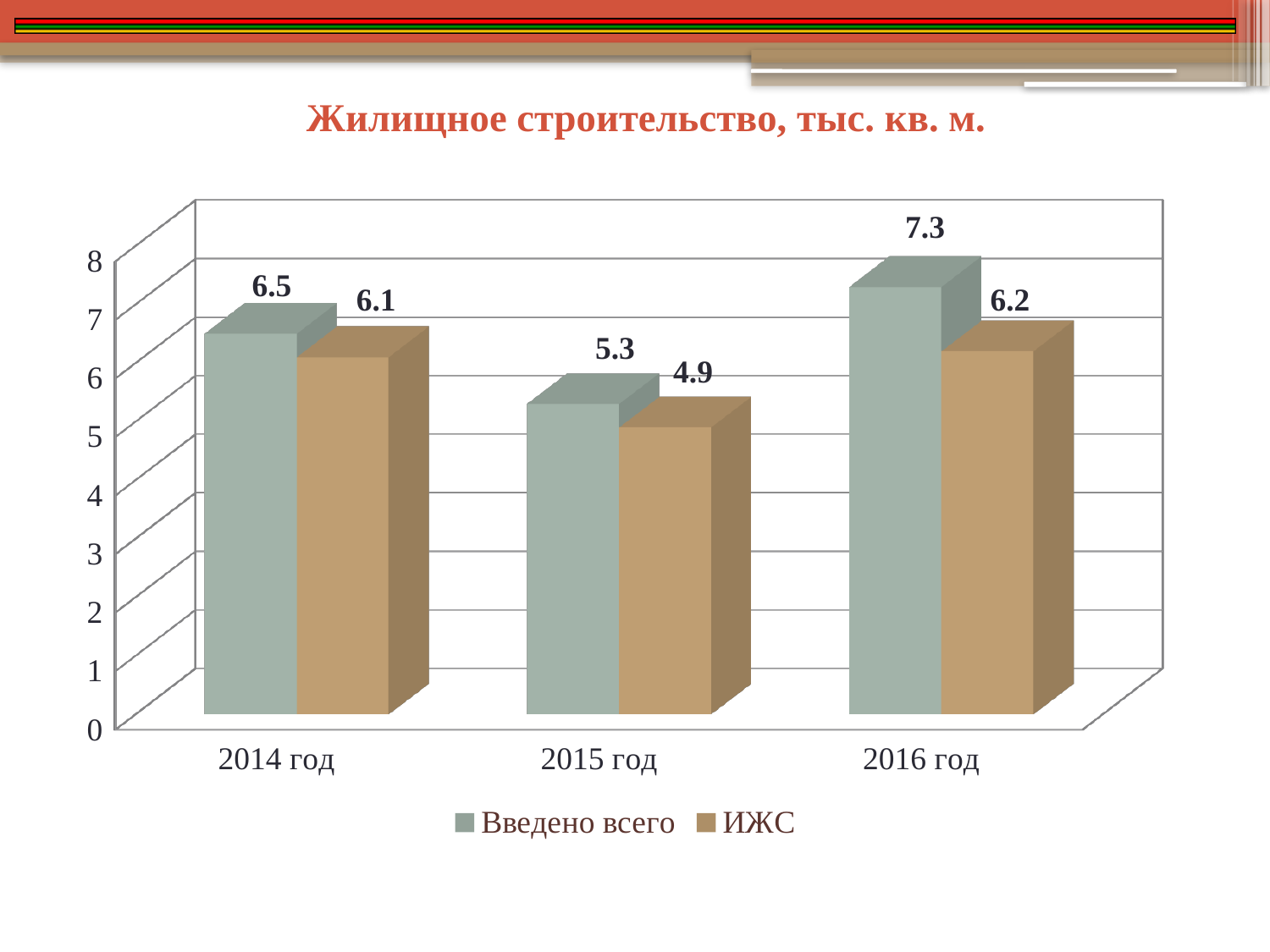
Which is larger: "ИЖС" in 2014 год or "ИЖС" in 2016 год? ИЖС in 2016 год What is the value of "ИЖС" for 2015 год? 4.9 Which year has the lowest value for "ИЖС"? 2015 год What kind of chart is shown on the slide? Bar chart What is the difference between "Введено всего" and "ИЖС" in 2016 год? 1.1 Which year has the highest value for "Введено всего"? 2016 год What is the title of the chart? Жилищное строительство, тыс. кв. м. How many series does the legend list? 2 What is the difference between the "Введено всего" values for 2016 год and 2015 год? 2 What is the value of "Введено всего" for 2016 год? 7.3 How many years are shown on the x axis? 3 What is the value of "Введено всего" for 2014 год? 6.5